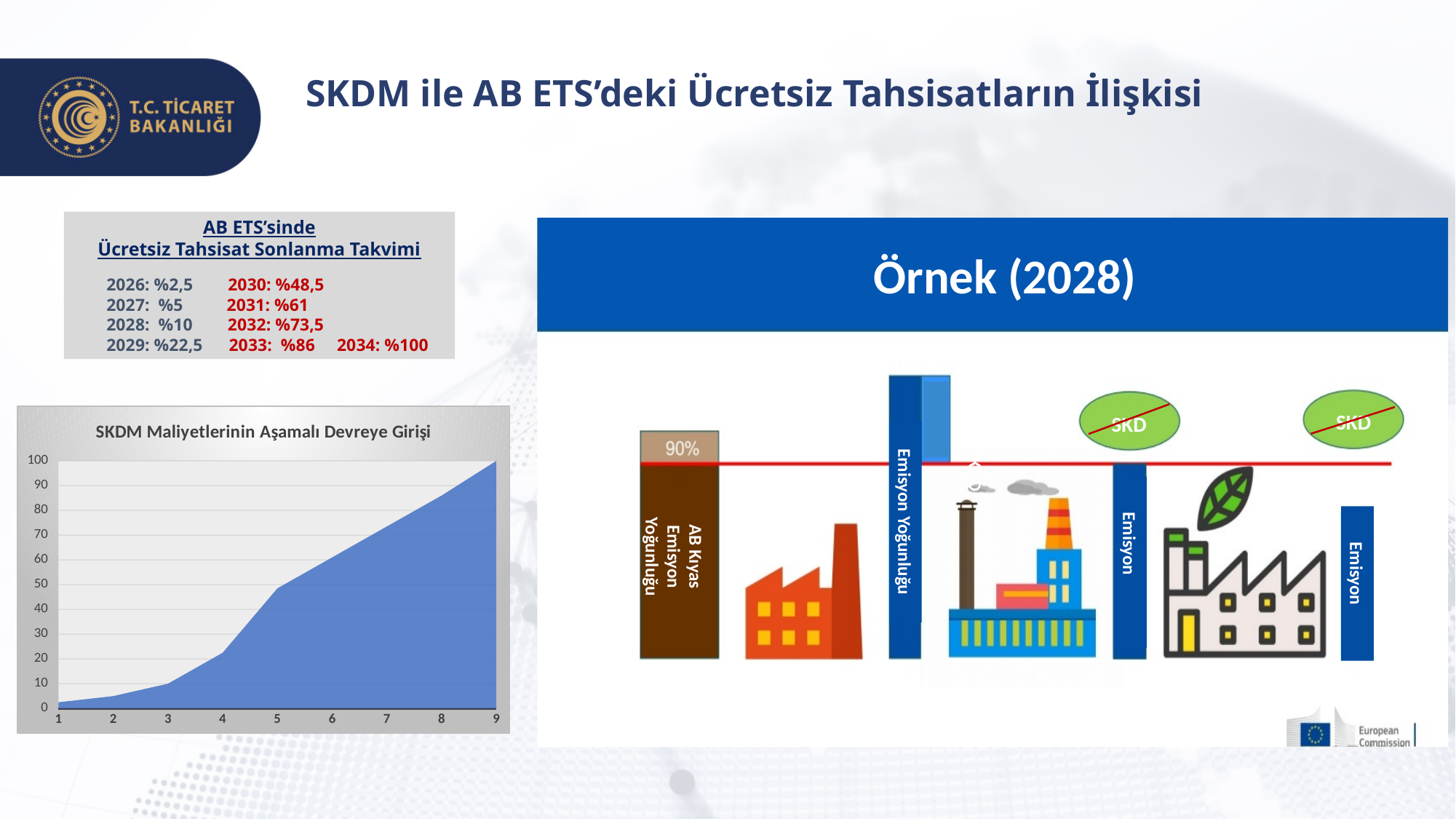
How many points are plotted along the x axis of the "SKDM Maliyetlerinin Aşamalı Devreye Girişi" chart? 9 In the "SKDM Maliyetlerinin Aşamalı Devreye Girişi" chart, is the value at x = 5 greater or less than 40? greater What kind of chart is "SKDM Maliyetlerinin Aşamalı Devreye Girişi"? Area chart In the "SKDM Maliyetlerinin Aşamalı Devreye Girişi" chart, is the value at x = 2 greater or less than 10? less In the "SKDM Maliyetlerinin Aşamalı Devreye Girişi" chart, is the value at x = 8 greater or less than 80? greater In the "SKDM Maliyetlerinin Aşamalı Devreye Girişi" chart, which has the larger value: x = 3 or x = 6? 6 What is the title of the area chart on the slide? SKDM Maliyetlerinin Aşamalı Devreye Girişi Do the values in the "SKDM Maliyetlerinin Aşamalı Devreye Girişi" chart rise or fall from x = 1 to x = 9? Rise At which x-axis point is the value highest in the "SKDM Maliyetlerinin Aşamalı Devreye Girişi" chart? 9 What is the highest tick value shown on the y axis of the "SKDM Maliyetlerinin Aşamalı Devreye Girişi" chart? 100 At which x-axis point is the value lowest in the "SKDM Maliyetlerinin Aşamalı Devreye Girişi" chart? 1